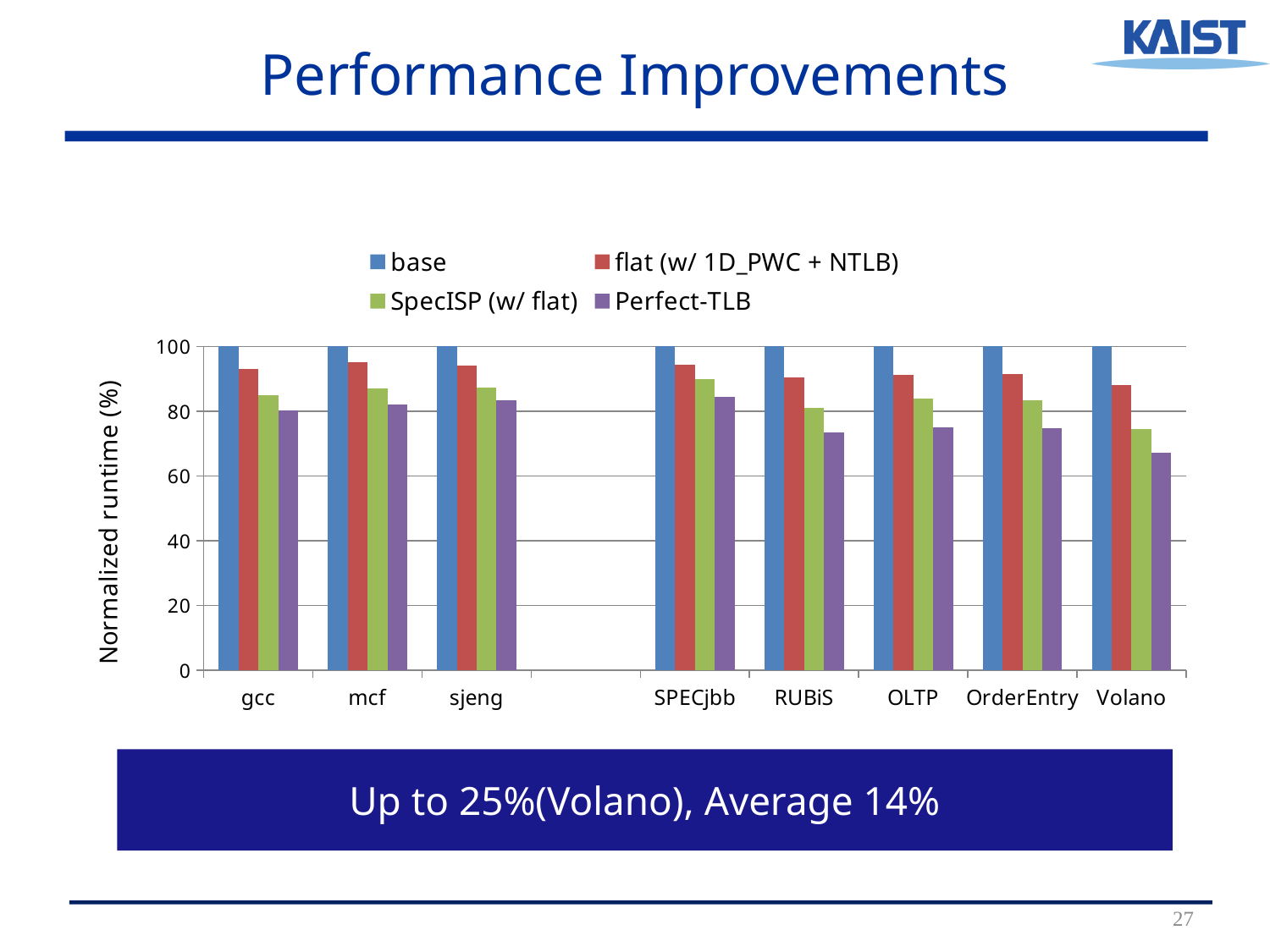
What kind of chart is shown on the slide? bar chart How many benchmark categories are shown on the x axis? 8 Which is larger, the SpecISP (w/ flat) value for SPECjbb or for RUBiS? SPECjbb Is the SpecISP (w/ flat) value for gcc greater or less than 80? greater What is the normalized runtime of the base series for gcc? 100 Is the Perfect-TLB value for RUBiS greater or less than 80? less What is the label of the y axis? Normalized runtime (%) Is the flat (w/ 1D_PWC + NTLB) value for Volano greater or less than 80? greater Which benchmark has the lowest Perfect-TLB normalized runtime? Volano How many series does the legend list? 4 Which is larger, the Perfect-TLB value for gcc or for Volano? gcc